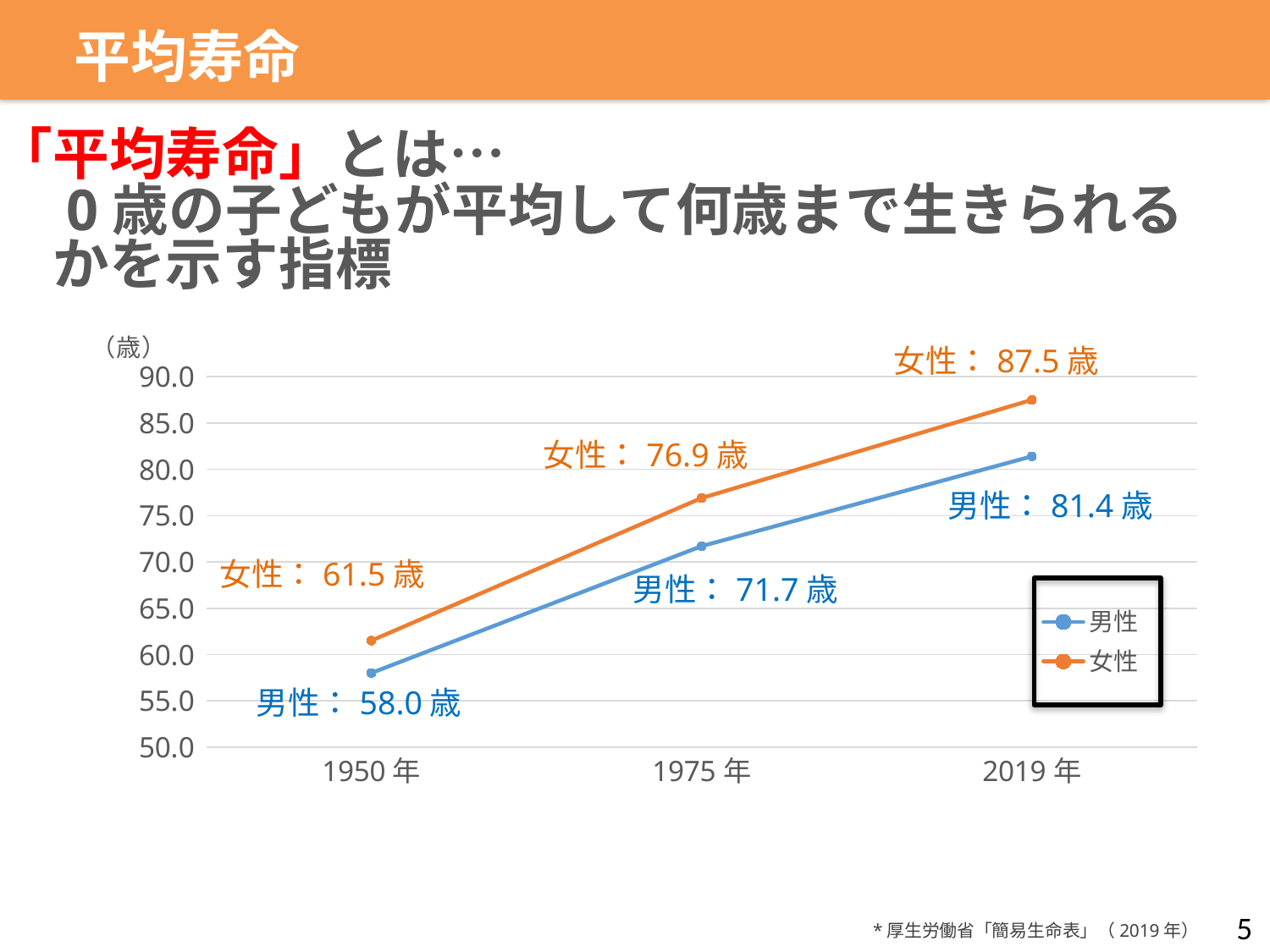
In which year is the value for 男性 lowest? 1950年 What is the value for 男性 in 2019年? 81.4歳 What kind of chart is shown on the slide? line chart How many years are shown on the x axis? 3 What is the value for 女性 in 1975年? 76.9歳 What is the value for 男性 in 1950年? 58.0歳 Which is larger in 1975年, 男性 or 女性? 女性 How many series does the legend list? 2 In which year is the value for 女性 highest? 2019年 What is the difference between 女性 and 男性 in 2019年? 6.1歳 What is the value for 女性 in 2019年? 87.5歳 What is the difference between the 男性 values in 2019年 and 1950年? 23.4歳